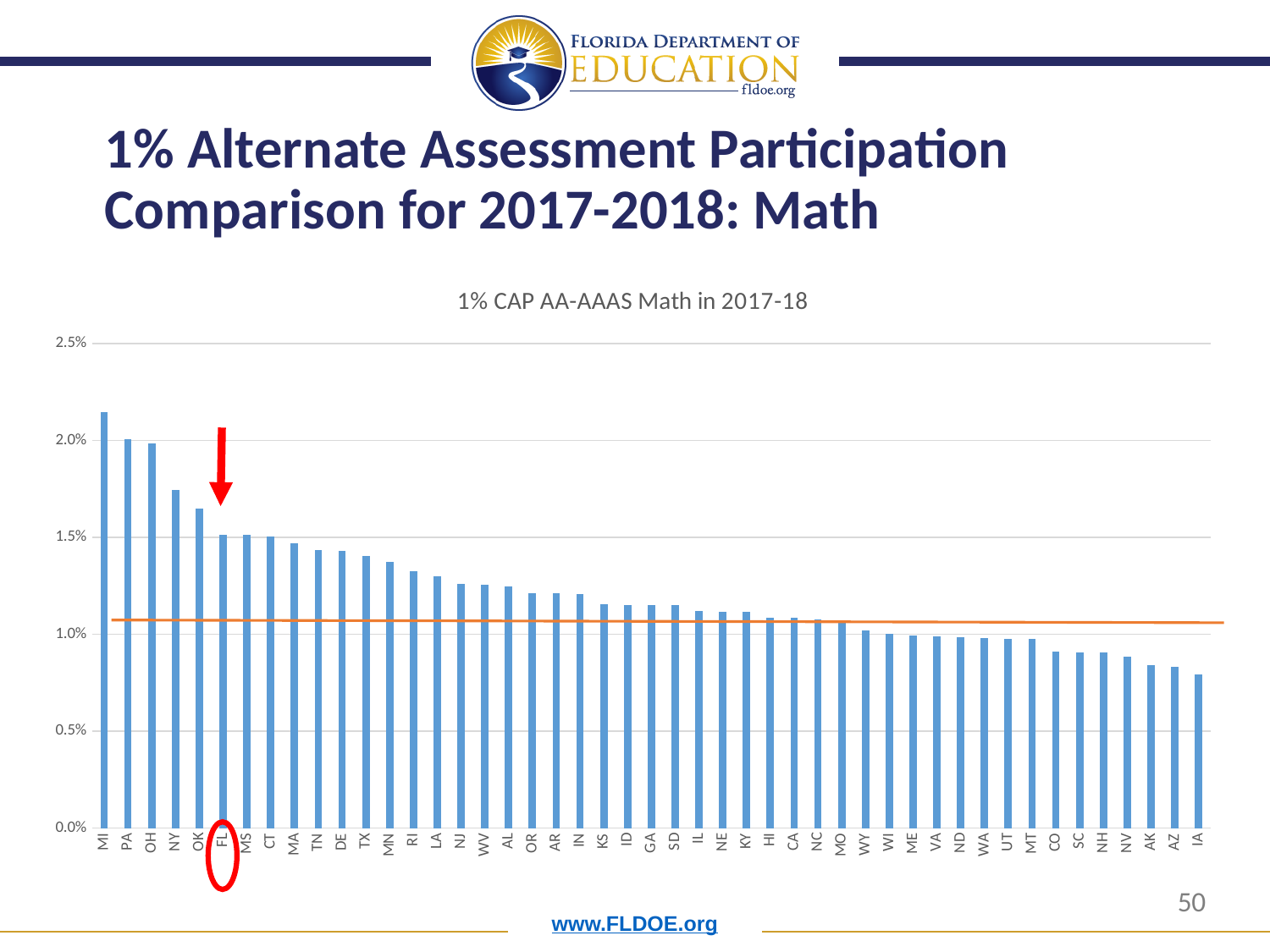
Is the value for CO greater or less than 1.0%? less Is the value for FL greater or less than 1.0%? greater Which state has the highest value in the chart? MI Is the value for NY greater or less than 1.5%? greater Which state has the lowest value in the chart? IA Which has the larger value, MI or PA? MI What kind of chart is shown on the slide? Bar chart What is the title of the chart? 1% CAP AA-AAAS Math in 2017-18 Which state's bar is circled and marked with a red arrow? FL Do the values rise or fall moving from left to right along the x axis? Fall